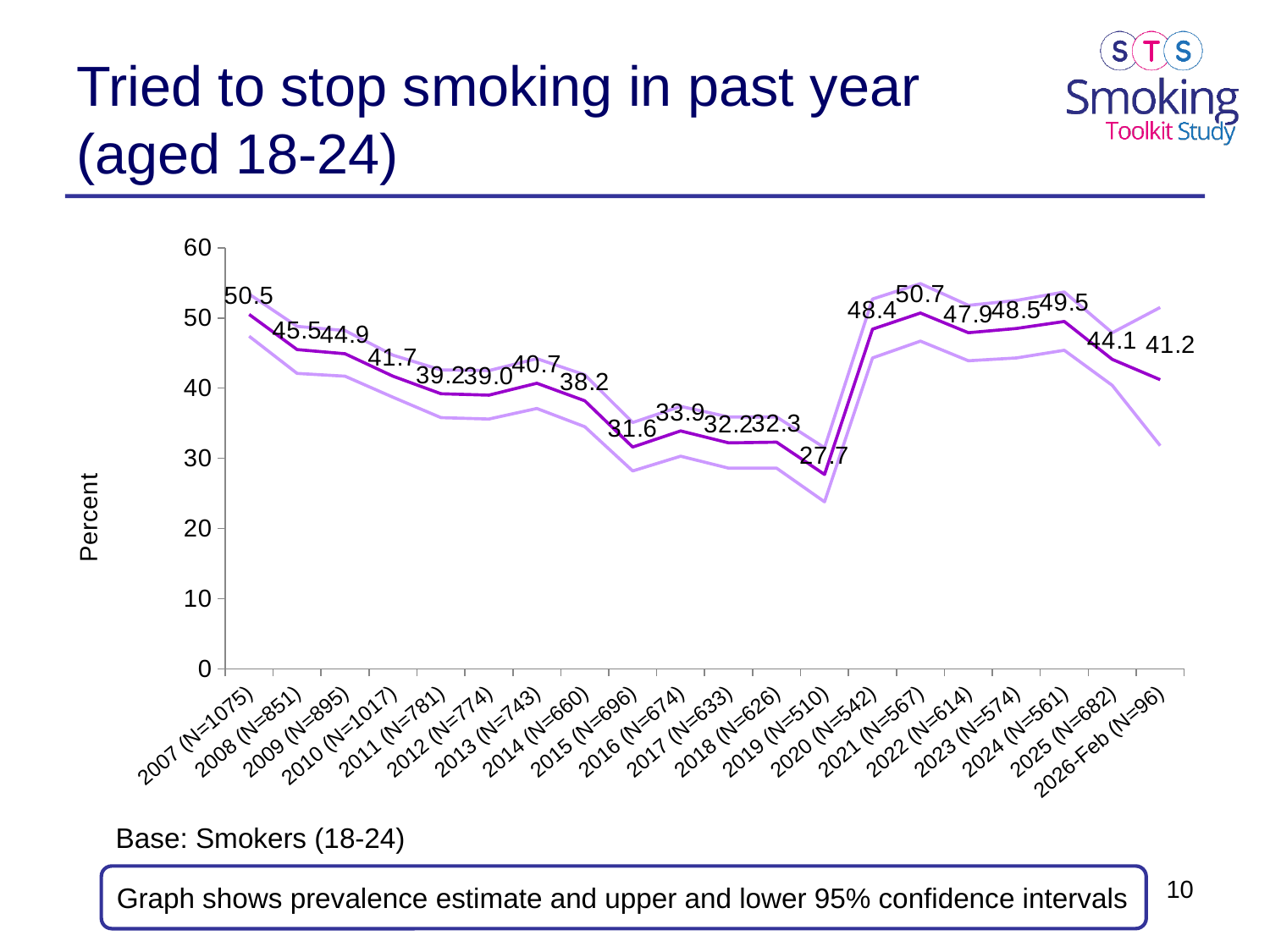
How many time points are plotted on the x axis? 20 What is the label on the y axis? Percent Does the prevalence estimate rise or fall from 2007 to 2012? fall Which year has the lowest prevalence estimate? 2019 (N=510) What is the prevalence estimate for 2013 (N=743)? 40.7 Is the lower confidence interval value for 2019 greater or less than 30? less What is the prevalence estimate for 2007 (N=1075)? 50.5 What kind of chart is shown on the slide? line chart What is the prevalence estimate for 2019 (N=510)? 27.7 Which year has the larger prevalence estimate, 2015 or 2016? 2016 What is the difference between the prevalence estimates for 2020 and 2019? 20.7 What is the prevalence estimate for 2026-Feb (N=96)? 41.2